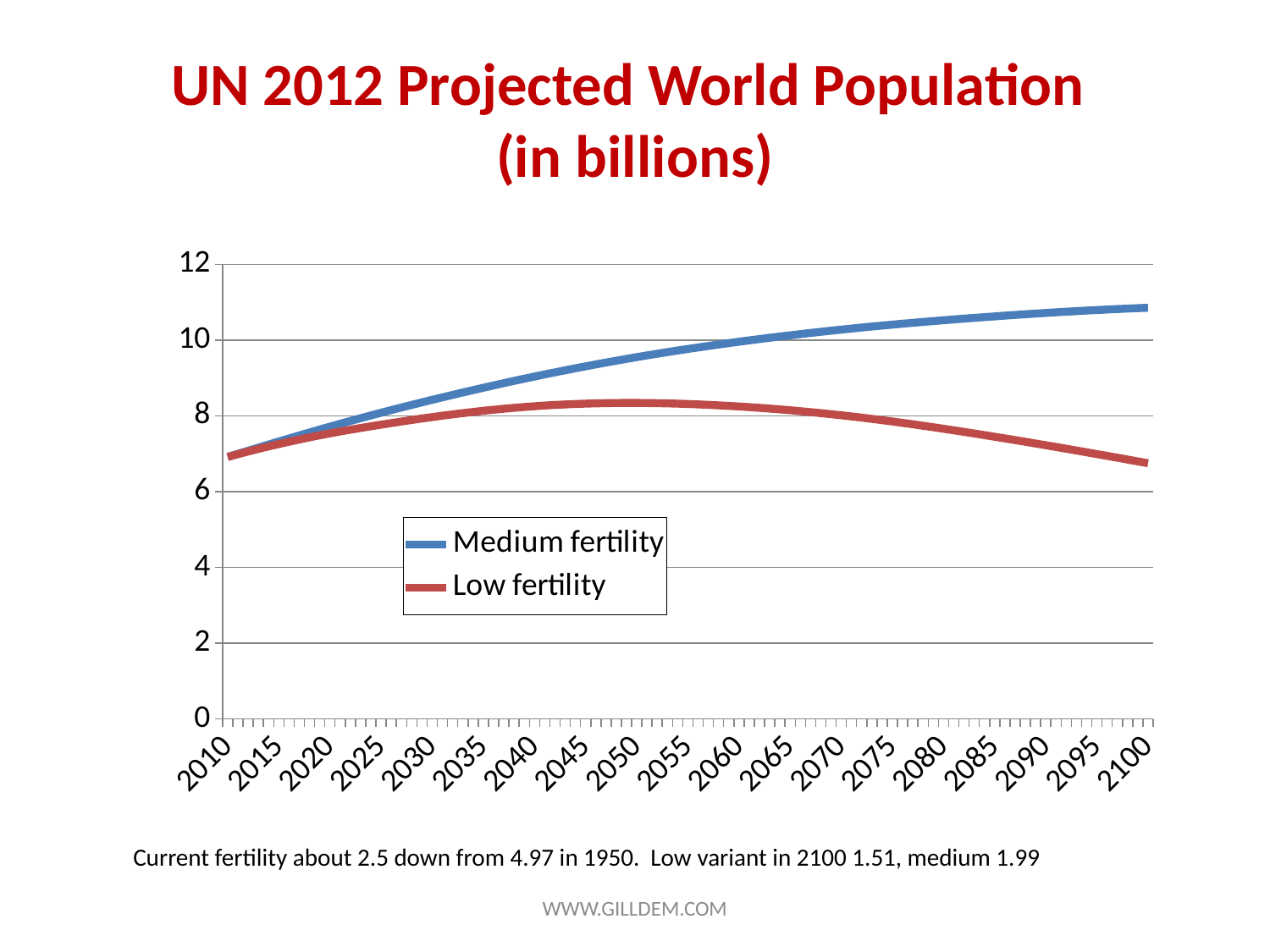
Does the Medium fertility line rise or fall from 2010 to 2100? rise What is the title of the chart? UN 2012 Projected World Population (in billions) Is the value for Medium fertility in 2050 greater or less than 8? greater What kind of chart is shown on the slide? line chart Does the Low fertility line rise or fall from 2050 to 2100? fall In 2100, which series has the higher value, Medium fertility or Low fertility? Medium fertility How many year labels are shown on the x axis? 19 Is the value for Medium fertility in 2100 greater or less than 10? greater How many series does the legend list? 2 Is the value for Medium fertility in 2010 greater or less than 8? less Which series is drawn in red? Low fertility